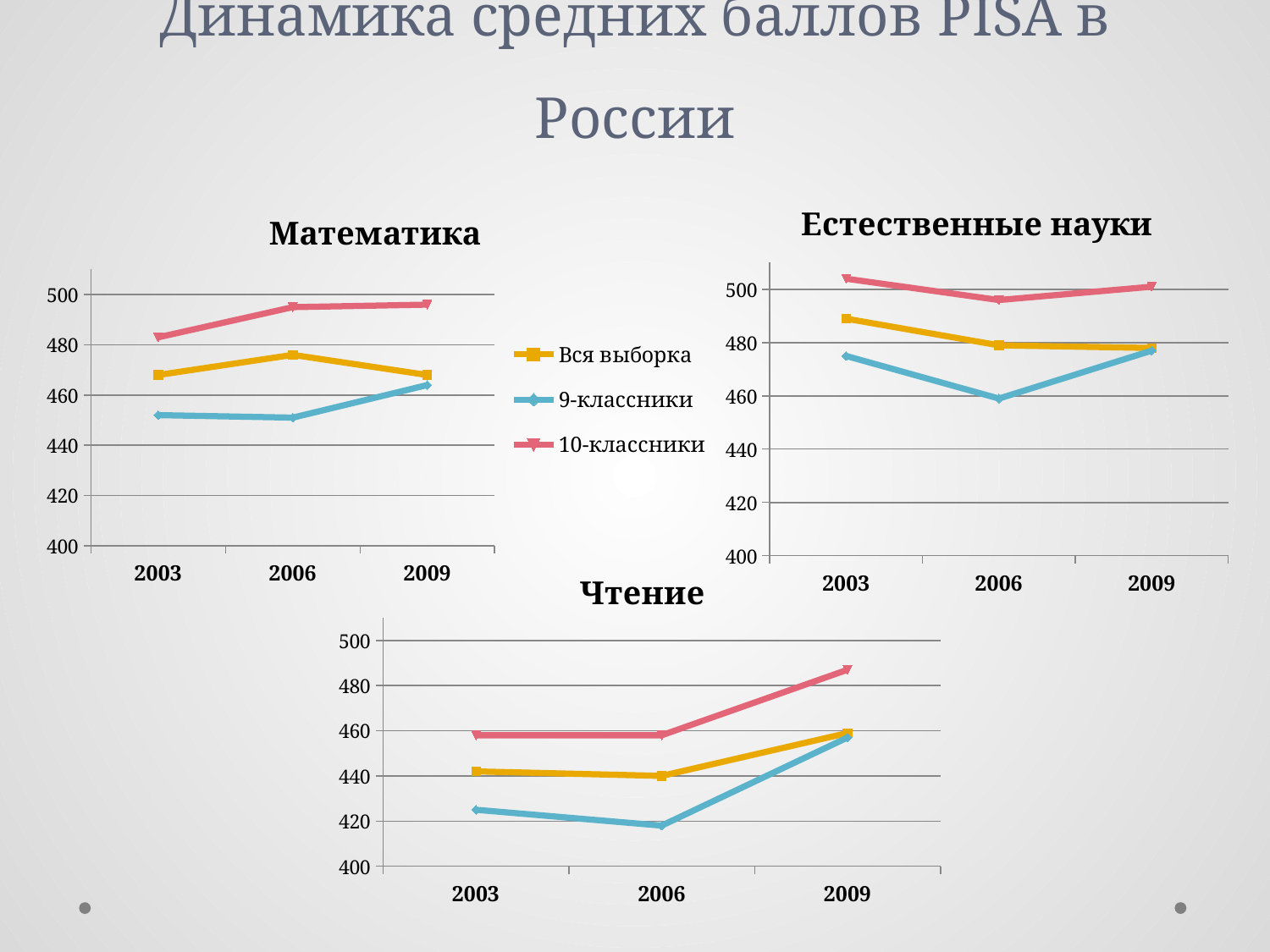
How many years are plotted on the x axis of the "Чтение" chart? 3 Which series is shown in pink in the legend? 10-классники In the "Чтение" chart, is the value for 10-классники in 2009 greater or less than 480? greater In the "Чтение" chart, is the value for 9-классники in 2003 greater or less than 420? greater In the "Естественные науки" chart, does the value for Вся выборка rise or fall from 2003 to 2009? fall In the "Чтение" chart, in which year is the value for 10-классники highest? 2009 In the "Естественные науки" chart, in which year is the value for 9-классники lowest? 2006 In the "Естественные науки" chart, is the value for 10-классники in 2003 greater or less than 500? greater What kind of chart is the "Математика" chart? line chart How many series does the legend list? 3 In the "Естественные науки" chart, which is larger in 2006: 10-классники or 9-классники? 10-классники